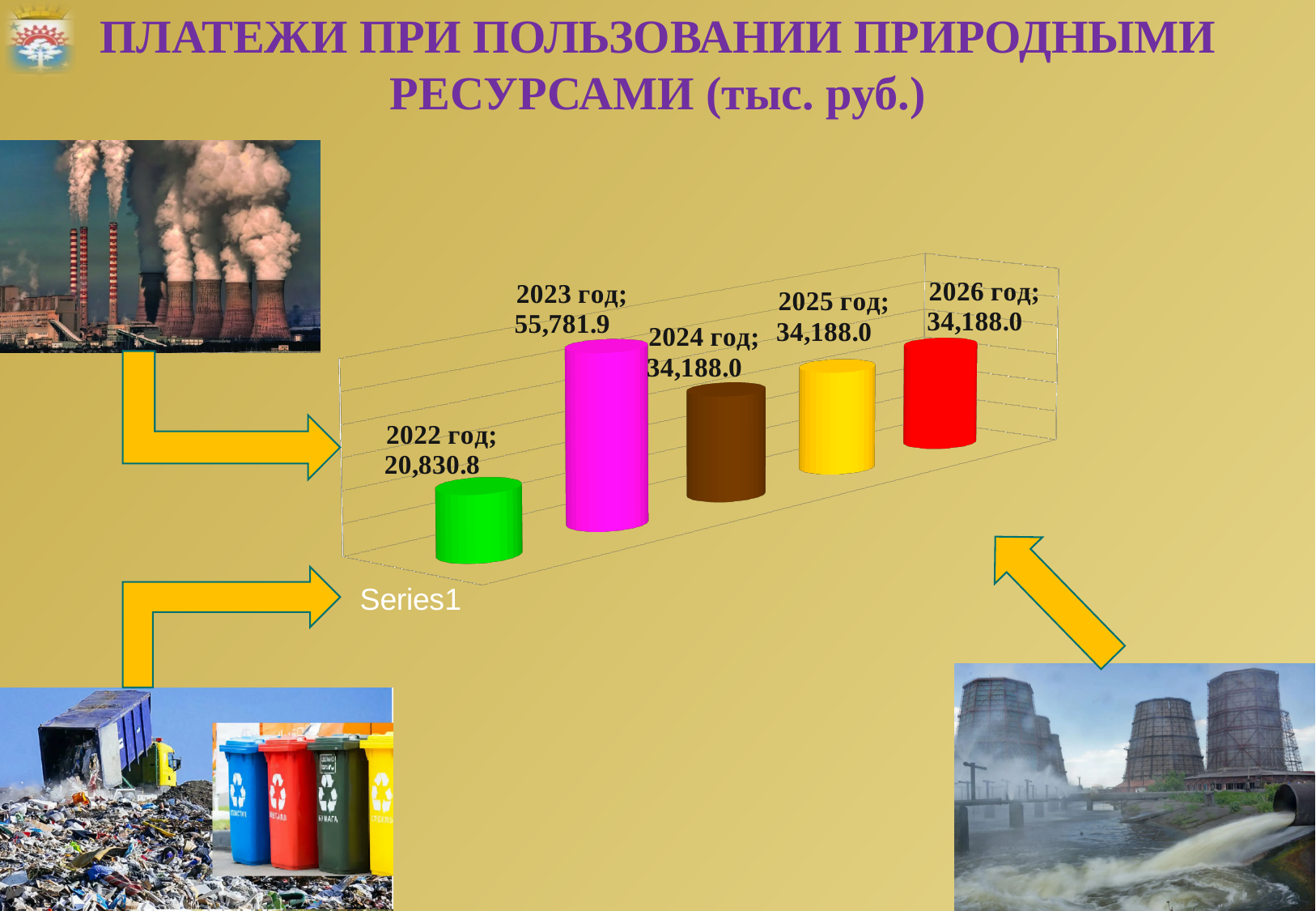
What is the difference between the values for 2023 год and 2025 год? 21,593.9 What is the value for 2026 год? 34,188.0 What unit is given in the chart title? тыс. руб. What is the value for 2022 год? 20,830.8 What kind of chart is shown on the slide? Bar chart Which year has the highest value? 2023 год Which is larger, the value for 2022 год or the value for 2024 год? 2024 год Which year has the lowest value? 2022 год What is the value for 2024 год? 34,188.0 How many years are shown in the chart? 5 What is the value for 2023 год? 55,781.9 What is the difference between the values for 2023 год and 2022 год? 34,951.1